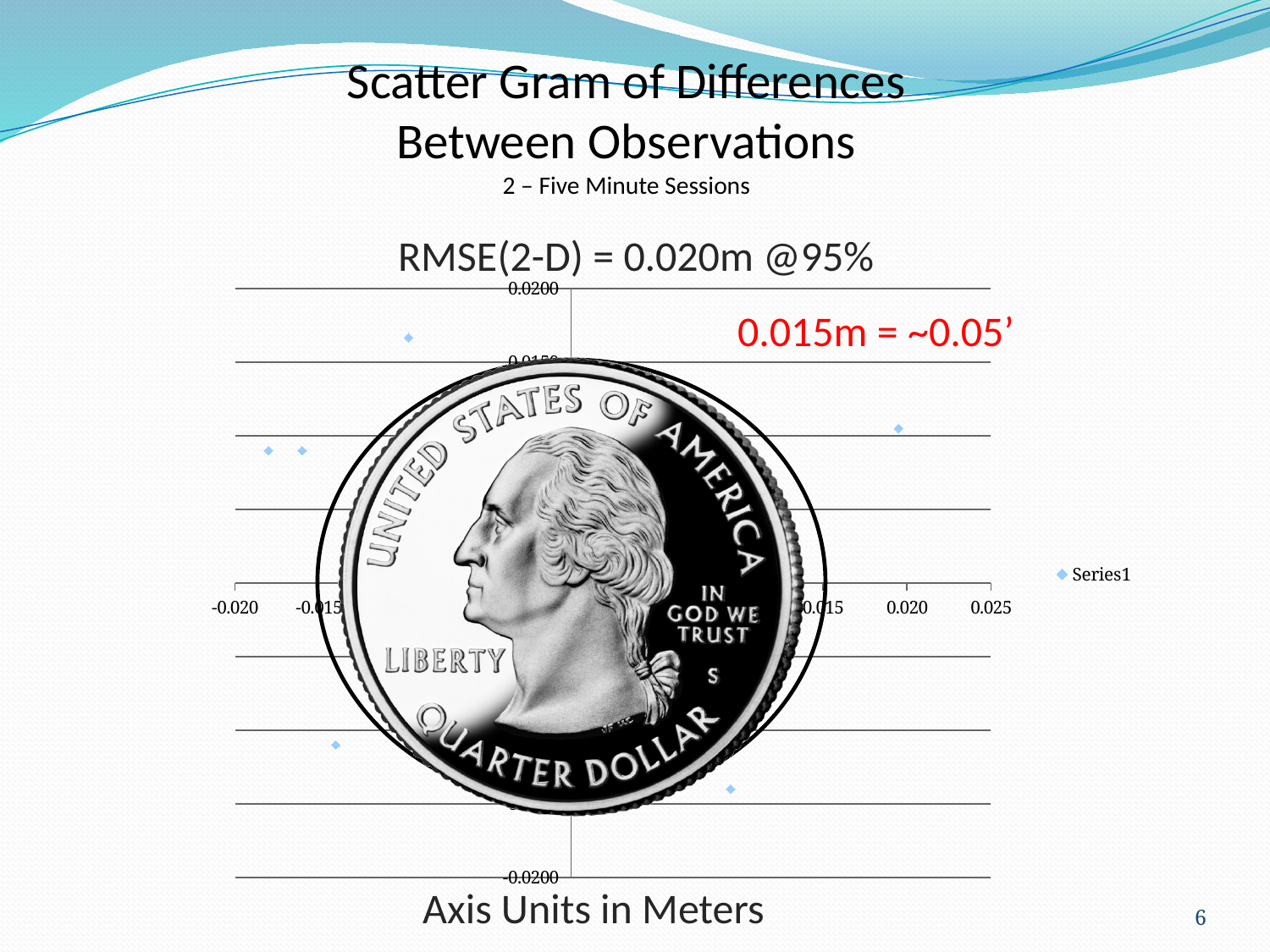
Is the x value of the rightmost plotted point greater or less than 0.025? less Is the y value of the highest plotted point greater or less than 0.0200? less What is the name of the series shown in the chart legend? Series1 Is the y value of the highest plotted point (upper left of the chart) greater or less than 0.0150? greater What kind of chart is shown on the slide? scatter chart What is the title of the chart? RMSE(2-D) = 0.020m @95% How many series does the chart legend list? 1